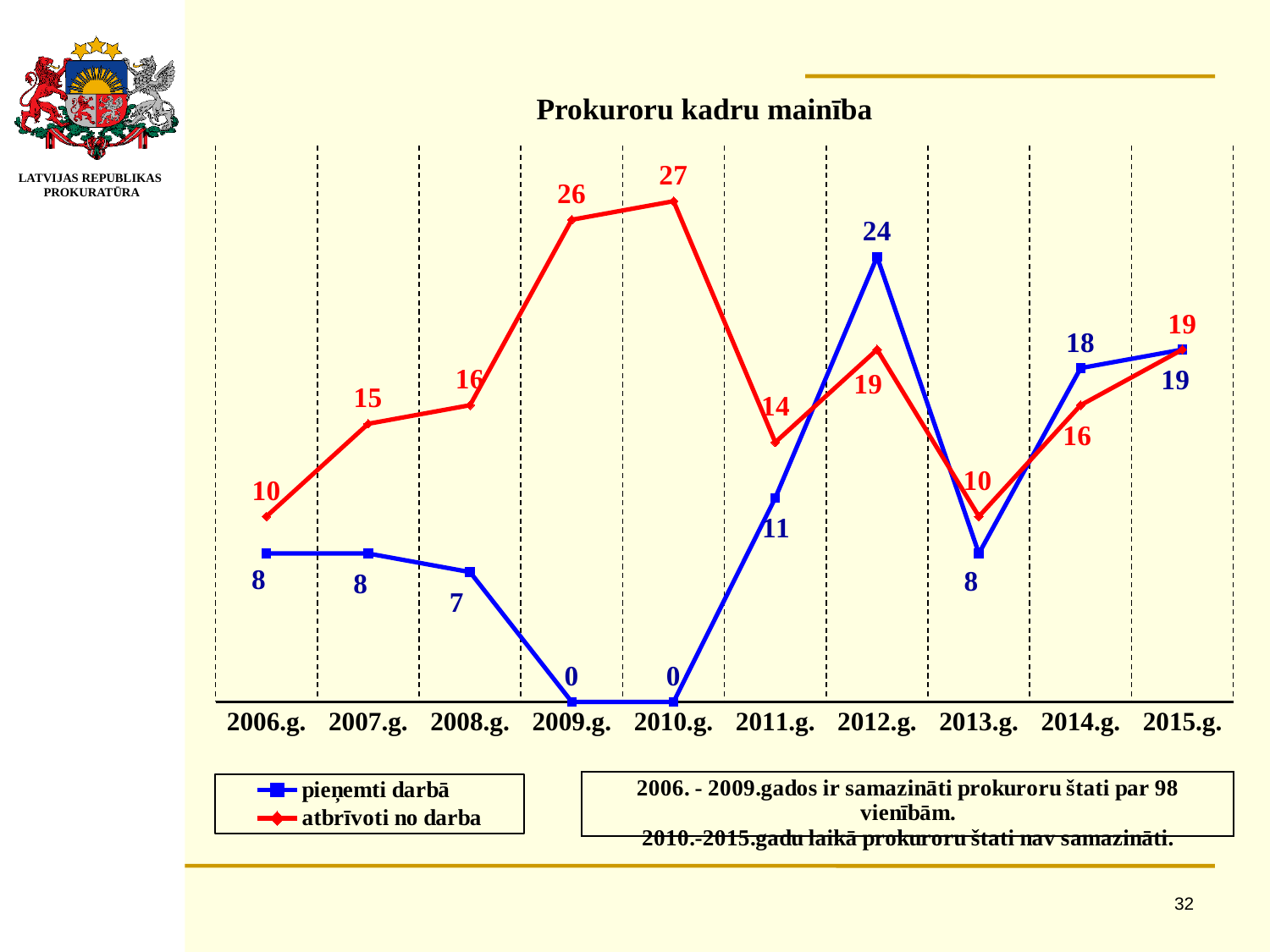
What is the value for "pieņemti darbā" in 2009.g.? 0 In which year is the "atbrīvoti no darba" series highest? 2010.g. What is the title of the chart? Prokuroru kadru mainība Which series has the larger value in 2012.g., "pieņemti darbā" or "atbrīvoti no darba"? pieņemti darbā What is the value for "pieņemti darbā" in 2012.g.? 24 How many years are shown on the x axis? 10 What is the difference between "atbrīvoti no darba" and "pieņemti darbā" in 2009.g.? 26 What is the value for "atbrīvoti no darba" in 2007.g.? 15 How many series does the legend list? 2 In which year is the "pieņemti darbā" series highest? 2012.g. What is the value for "atbrīvoti no darba" in 2010.g.? 27 What kind of chart is shown on the slide? line chart